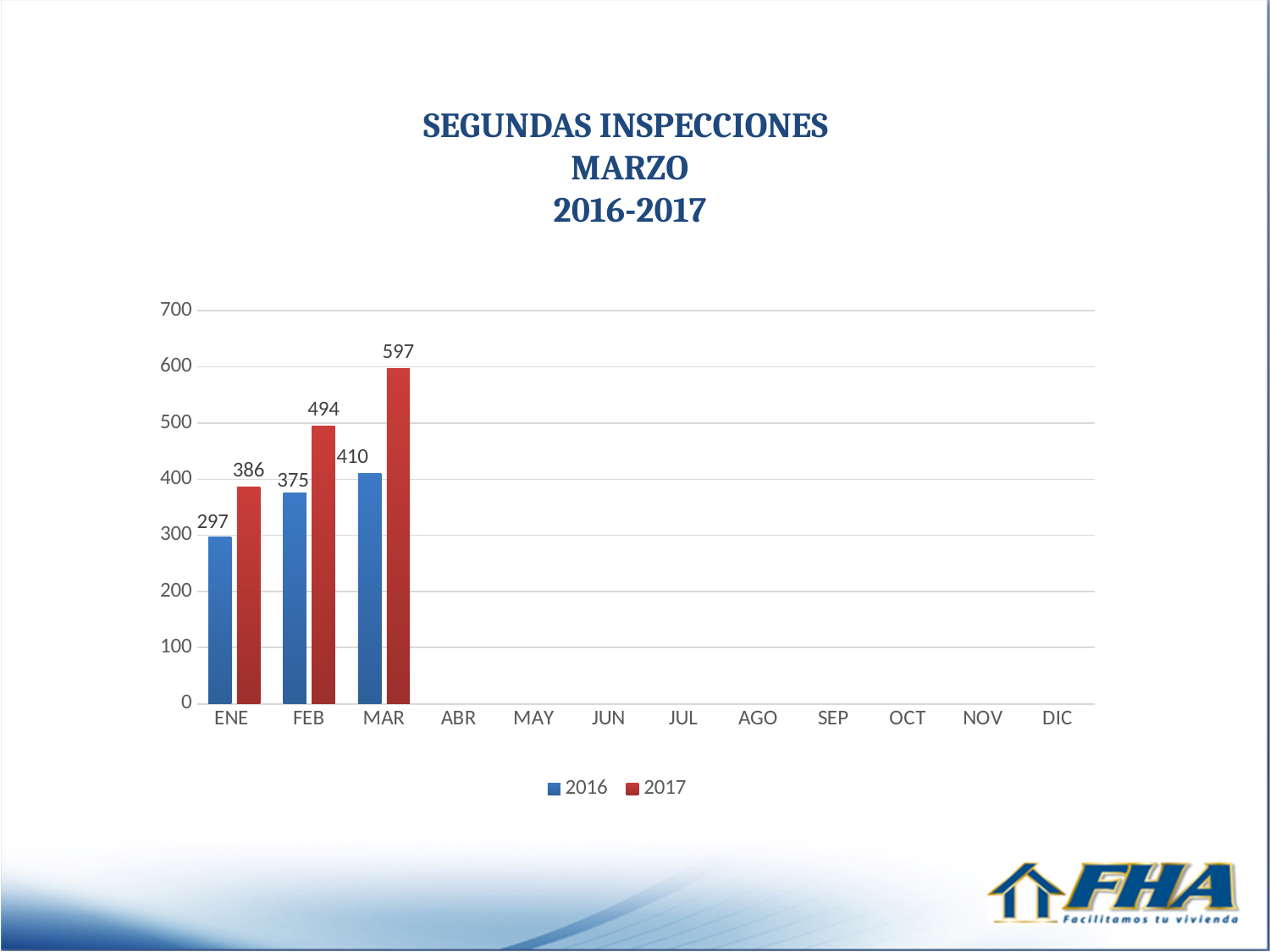
Which month has the lowest value for the 2016 series? ENE How many series does the legend list? 2 Which is larger in FEB, the 2016 value or the 2017 value? 2017 How many month categories are shown on the x axis? 12 What kind of chart is shown on the slide? Bar chart What is the value for 2017 in FEB? 494 Do the 2017 values rise or fall from ENE to MAR? Rise Which month has the highest value for the 2017 series? MAR What colour are the bars for the 2017 series? Red What is the value for 2016 in ENE? 297 What is the difference between the 2017 and 2016 values in MAR? 187 What is the value for 2016 in MAR? 410